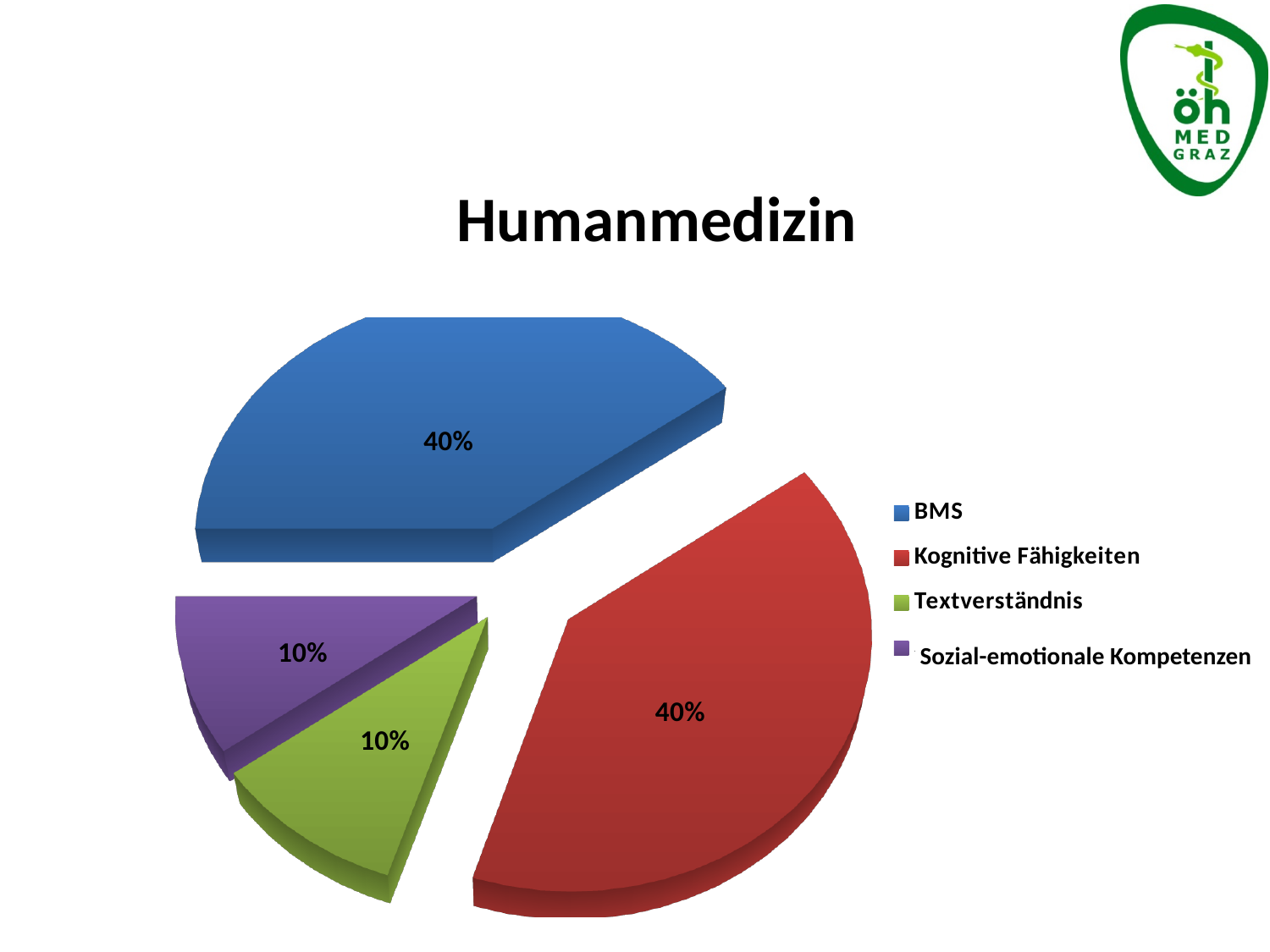
What is the title of the chart? Humanmedizin Which colour represents Kognitive Fähigkeiten in the chart? red What share of the pie does Kognitive Fähigkeiten have? 40% What is the combined share of Textverständnis and Sozial-emotionale Kompetenzen? 20% What share of the pie does Sozial-emotionale Kompetenzen have? 10% What share of the pie does Textverständnis have? 10% How many slices does the pie chart have? 4 What share of the pie does BMS have? 40% Which is larger, the share for BMS or the share for Textverständnis? BMS What is the difference between the share for Kognitive Fähigkeiten and the share for Sozial-emotionale Kompetenzen? 30% What kind of chart is shown on the slide? pie chart How many entries does the legend list? 4